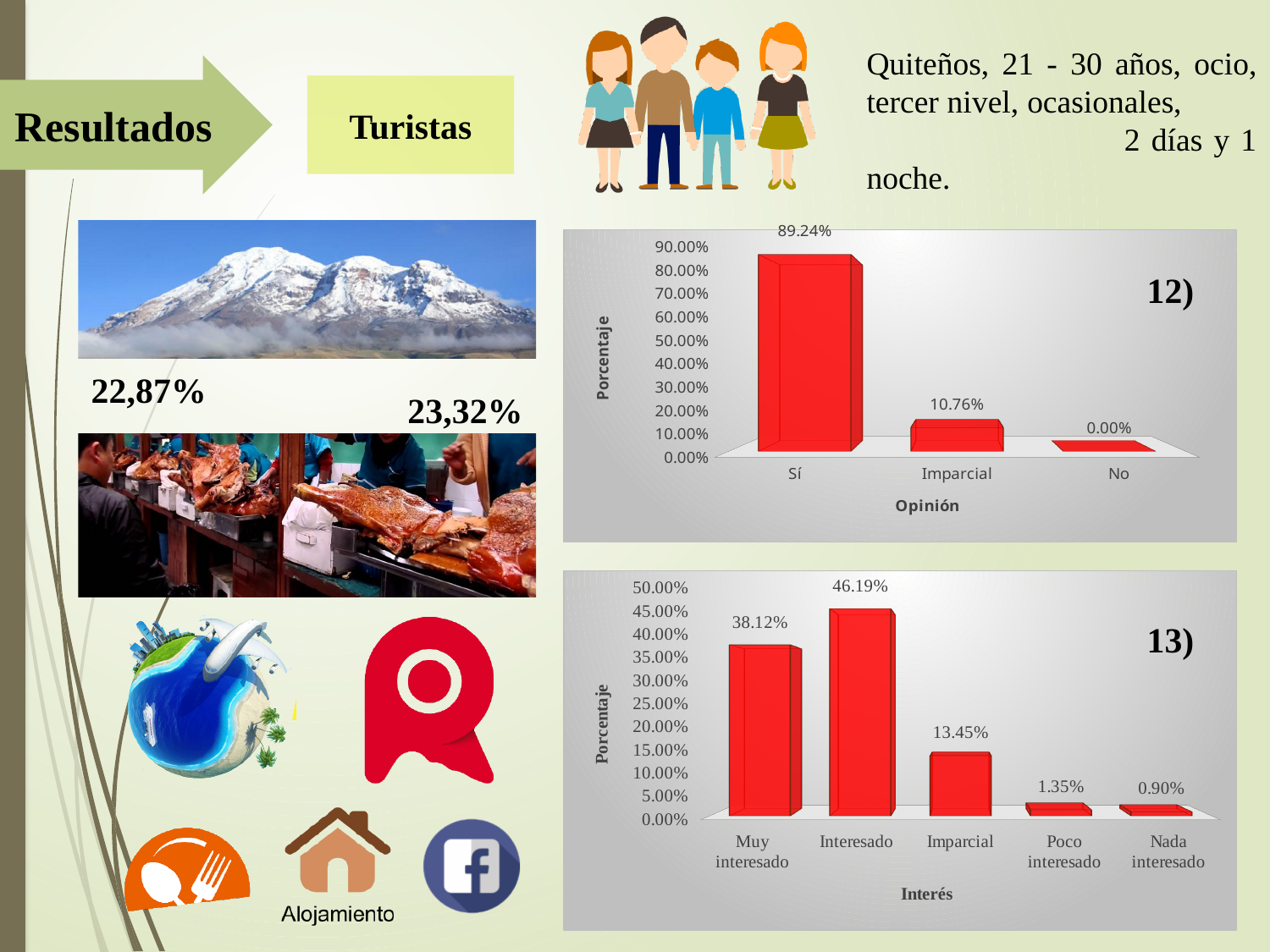
In chart 13) (Interés), what is the difference between Interesado and Muy interesado? 8.07% In chart 12) (Opinión), which category has the lowest value? No In chart 12) (Opinión), what is the value for Imparcial? 10.76% In chart 12) (Opinión), how many categories are shown on the x axis? 3 In chart 12) (Opinión), what is the difference between the values for Sí and Imparcial? 78.48% In chart 13) (Interés), how many categories are shown on the x axis? 5 In chart 13) (Interés), which category has the highest value? Interesado What type of chart is chart 13) (Interés)? Bar chart In chart 13) (Interés), which is larger, Muy interesado or Imparcial? Muy interesado In chart 12) (Opinión), what is the value for Sí? 89.24% In chart 13) (Interés), what is the value for Poco interesado? 1.35% In chart 13) (Interés), what is the value for Interesado? 46.19%